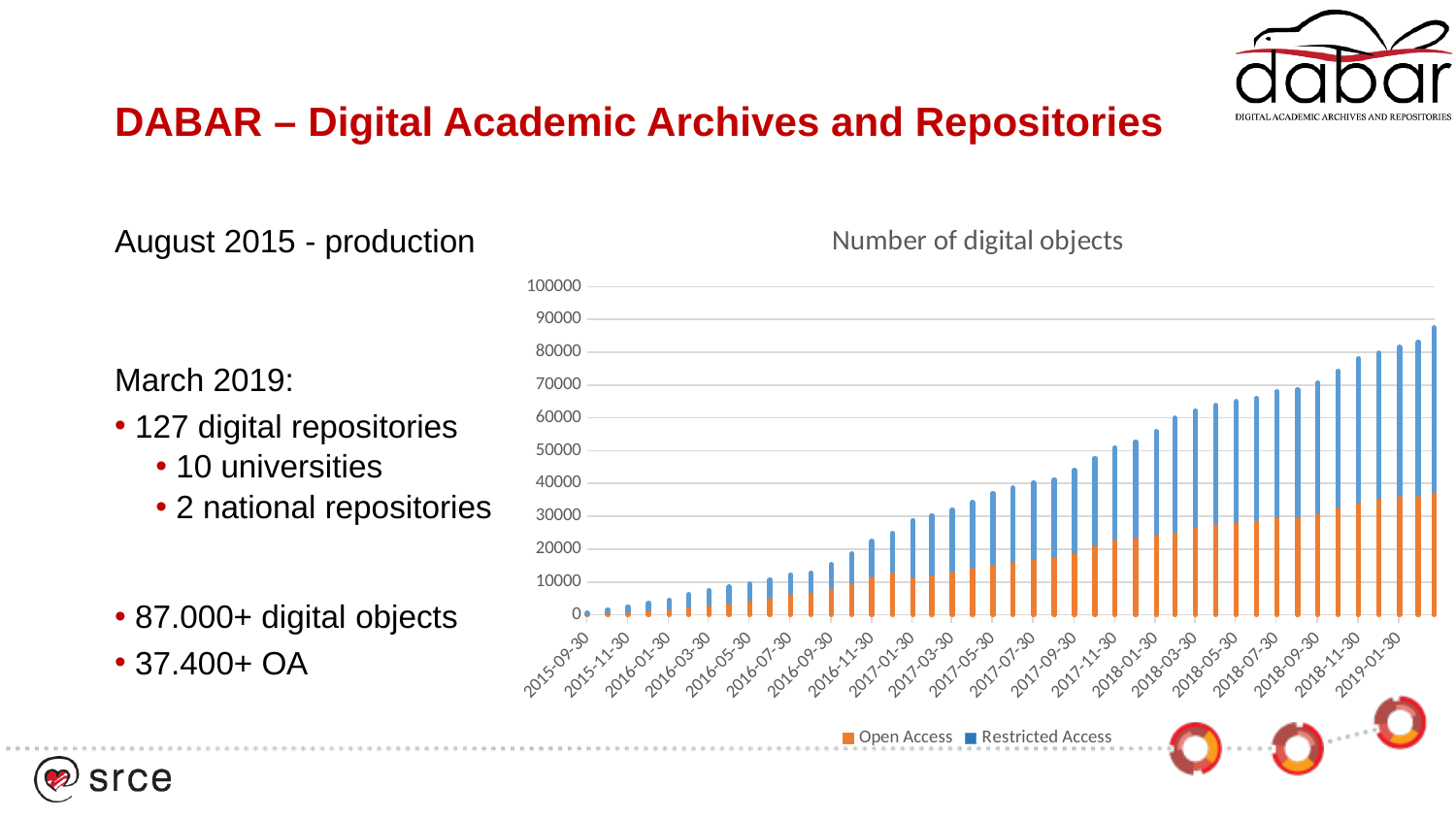
Which has the larger total number of digital objects, 2016-01-30 or 2018-01-30? 2018-01-30 Do the total number of digital objects rise or fall from 2015-09-30 to 2019-01-30? Rise Which labelled date has the lowest total number of digital objects? 2015-09-30 What kind of chart is shown on the slide? Stacked bar chart Is the total value for 2018-01-30 greater or less than 50000? greater What is the title of the chart? Number of digital objects Is the Open Access value for 2019-01-30 greater or less than 30000? greater How many series does the chart's legend list? 2 Is the total value for 2016-09-30 greater or less than 10000? greater Which series is shown in orange in the chart? Open Access